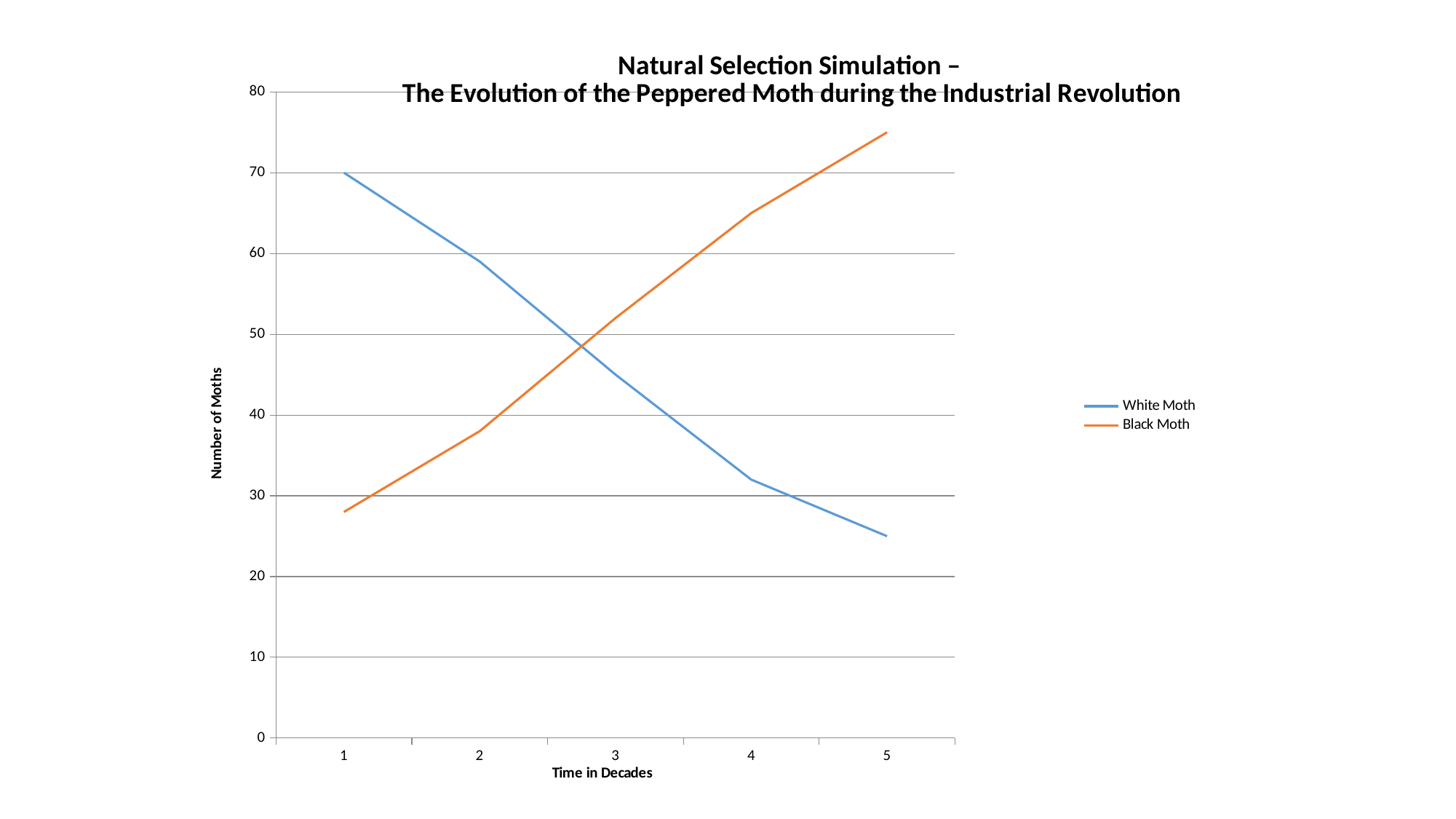
Is the value for Black Moth at decade 1 greater or less than 30? less At which decade is the White Moth value highest? 1 How many series does the legend list? 2 What is the title of the vertical axis? Number of Moths Is the value for Black Moth at decade 5 greater or less than 70? greater What kind of chart is shown on the slide? line chart Is the value for White Moth at decade 5 greater or less than 30? less How many time points (decades) are plotted along the x axis? 5 What is the number of White Moths at decade 1? 70 Does the Black Moth line rise or fall from decade 1 to decade 5? rise At decade 4, which series has the larger value, White Moth or Black Moth? Black Moth Does the White Moth line rise or fall from decade 1 to decade 5? fall